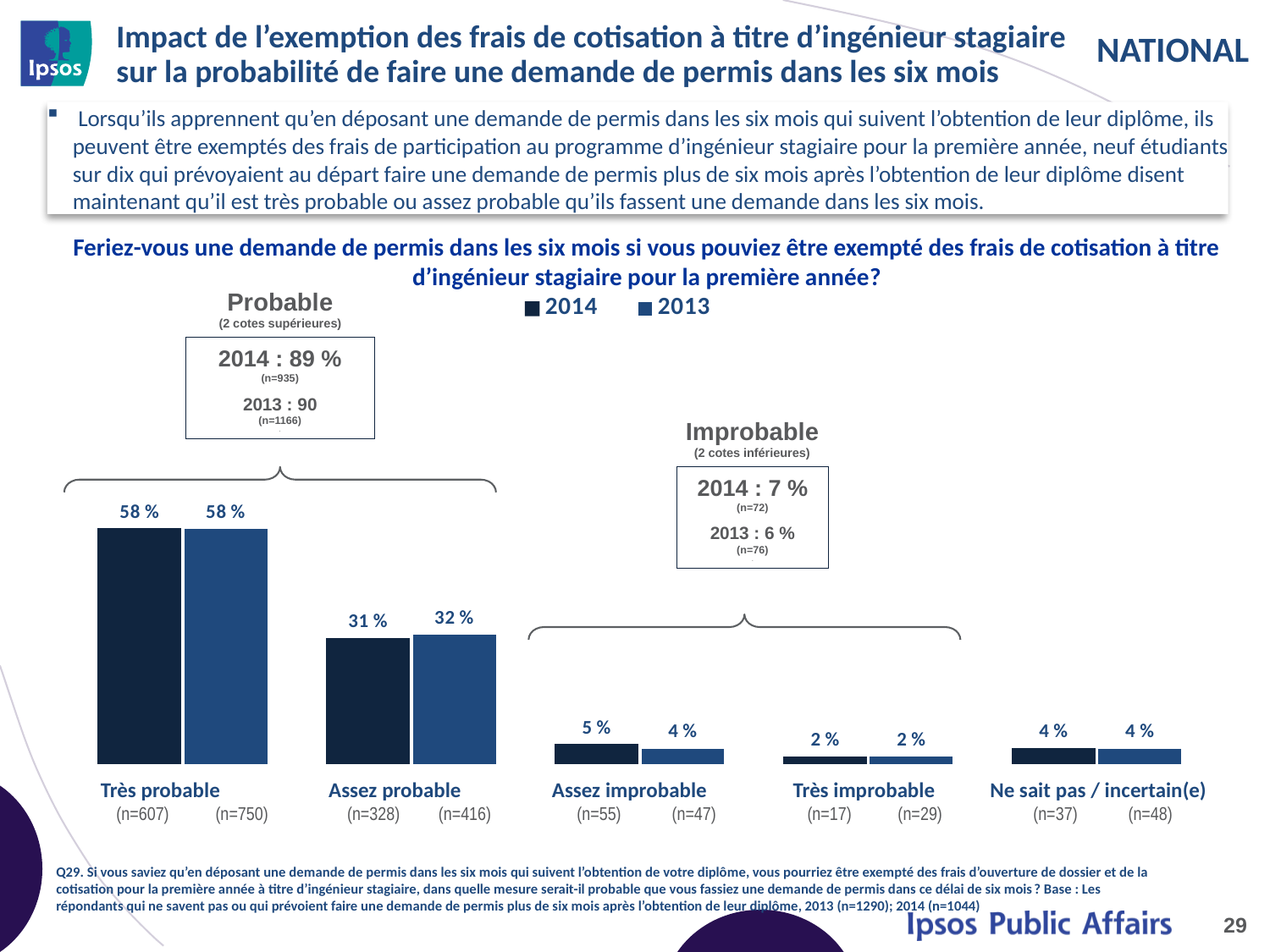
What are the two series named in the chart legend? 2014 and 2013 What is the 2014 value for "Assez improbable"? 5 % What is the difference between the 2014 values for "Très probable" and "Assez probable"? 27 % What kind of chart is shown on the slide? Bar chart How many categories are shown on the x axis of the chart? 5 What is the 2014 value for "Très probable"? 58 % Which is larger for "Assez improbable": the 2014 value or the 2013 value? 2014 Which category has the lowest 2013 value? Très improbable What is the 2013 value for "Assez probable"? 32 % How many series does the legend list? 2 Which category has the highest 2014 value? Très probable What is the 2013 value for "Ne sait pas / incertain(e)"? 4 %